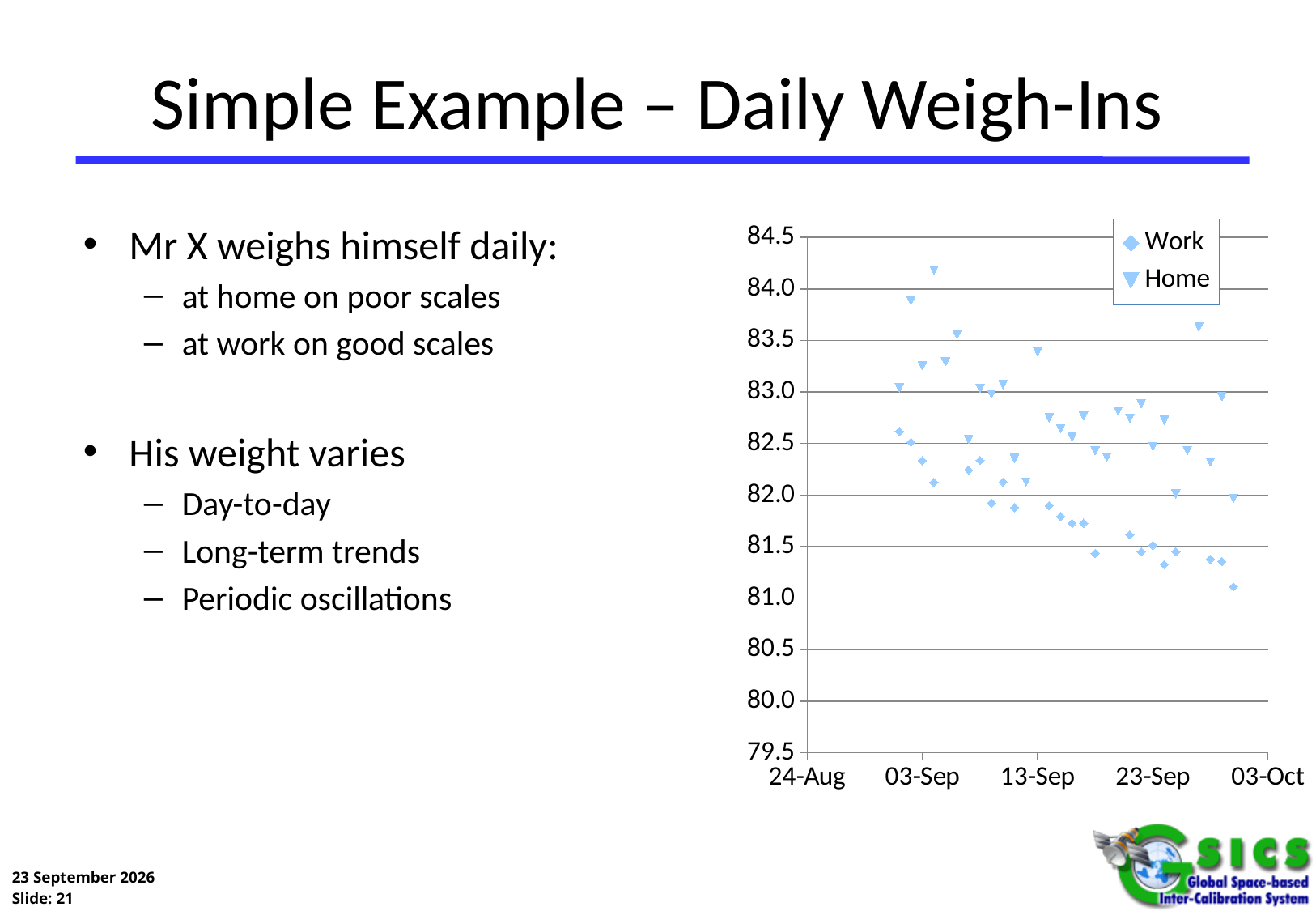
Which marker shape is used for the Home series in the chart? triangle What kind of chart is shown on the slide? scatter chart Is the first Work value (around the start of September) greater or less than 82.0? greater Do the Work values generally rise or fall from early September to early October? fall Which series generally shows higher weight values, Work or Home? Home What are the two series named in the chart legend? Work and Home Is the lowest Home value greater or less than 81.5? greater Is the highest Home value greater or less than 84.0? greater How many series does the chart legend list? 2 What is the lowest value shown on the y axis of the chart? 79.5